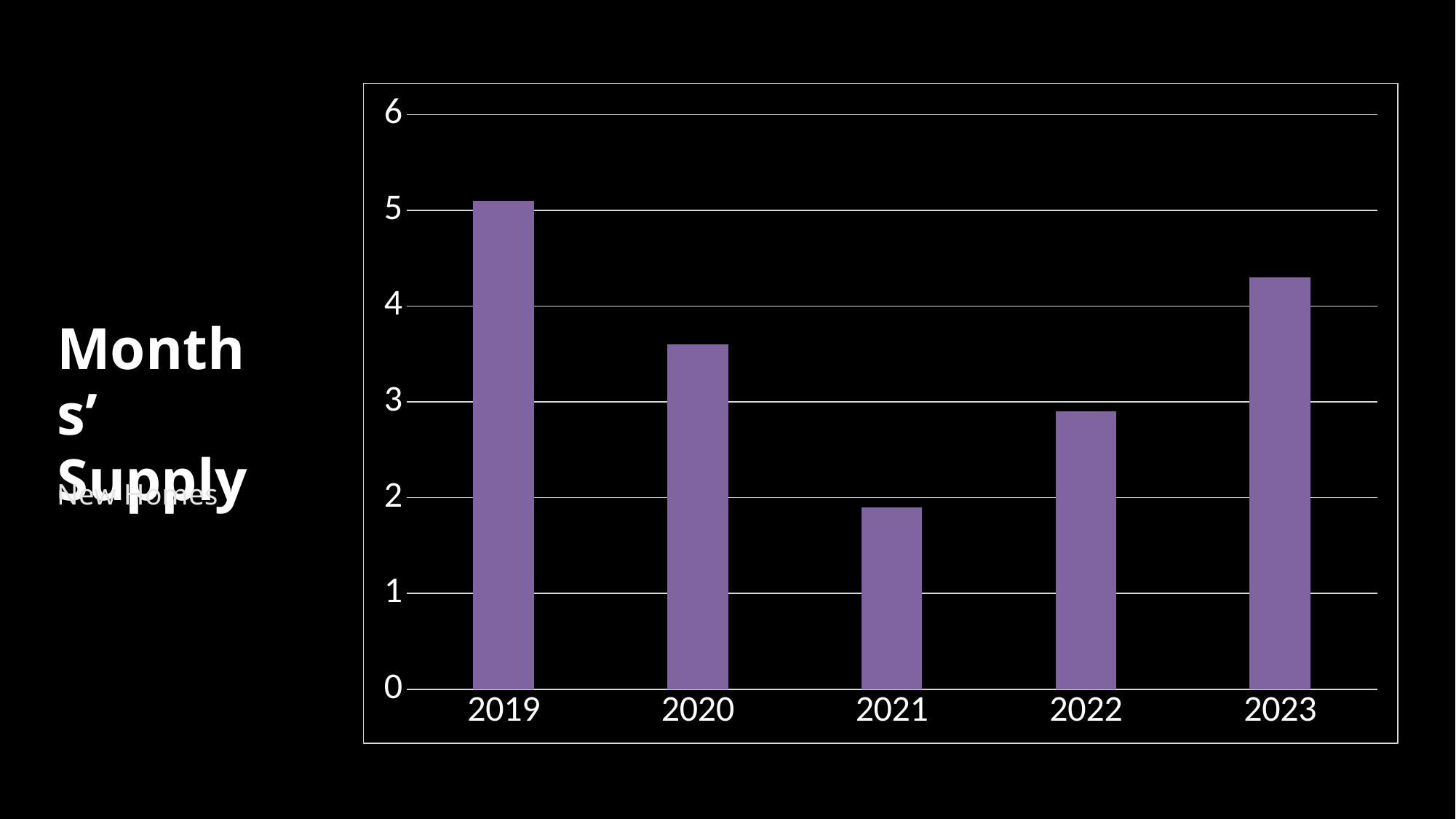
Is the value for 2021 greater or less than 3? less Is the value for 2019 greater or less than 4? greater Which year has the highest bar in the chart? 2019 Which year has the larger value, 2020 or 2022? 2020 Which year has the larger value, 2023 or 2020? 2023 Is the value for 2023 greater or less than 5? less What is the title of the chart on the slide? Months' Supply Which year has the lowest bar in the chart? 2021 How many years are shown on the x axis of the chart? 5 Do the values rise or fall from 2021 to 2023? rise What kind of chart is shown on the slide? bar chart